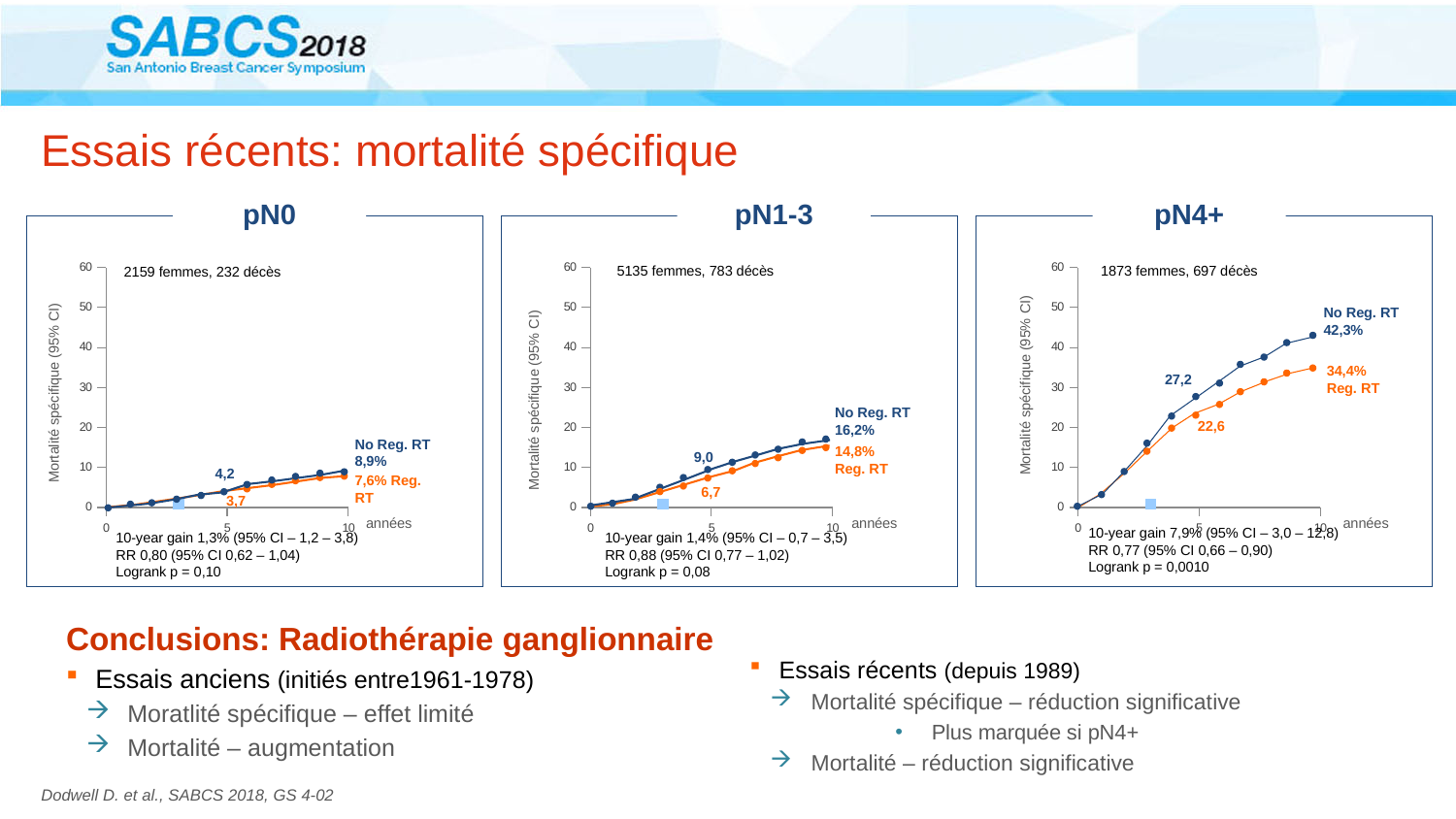
How many women are included in the pN1-3 chart? 5135 femmes In the pN0 chart, what is the difference between the 5-year values for No Reg. RT (4,2) and Reg. RT (3,7)? 0,5 In the pN4+ chart, is the 10-year value for No Reg. RT greater or less than 40? greater In the pN1-3 chart, what is the 10-year specific mortality for No Reg. RT? 16,2% In the pN1-3 chart, which curve has the higher 10-year value, No Reg. RT or Reg. RT? No Reg. RT In the pN1-3 chart, what value is labelled on the Reg. RT curve at 5 years? 6,7 In the pN0 chart, what is the 10-year specific mortality for Reg. RT? 7,6% What kind of chart is used in the pN0 panel? Line chart In the pN4+ chart, do the curves rise or fall as the years increase? Rise In the pN4+ chart, what is the 10-year specific mortality for Reg. RT? 34,4% In the pN4+ chart, what is the 10-year specific mortality for No Reg. RT? 42,3% In the pN4+ chart, what is the difference between the 10-year values for No Reg. RT and Reg. RT? 7,9%